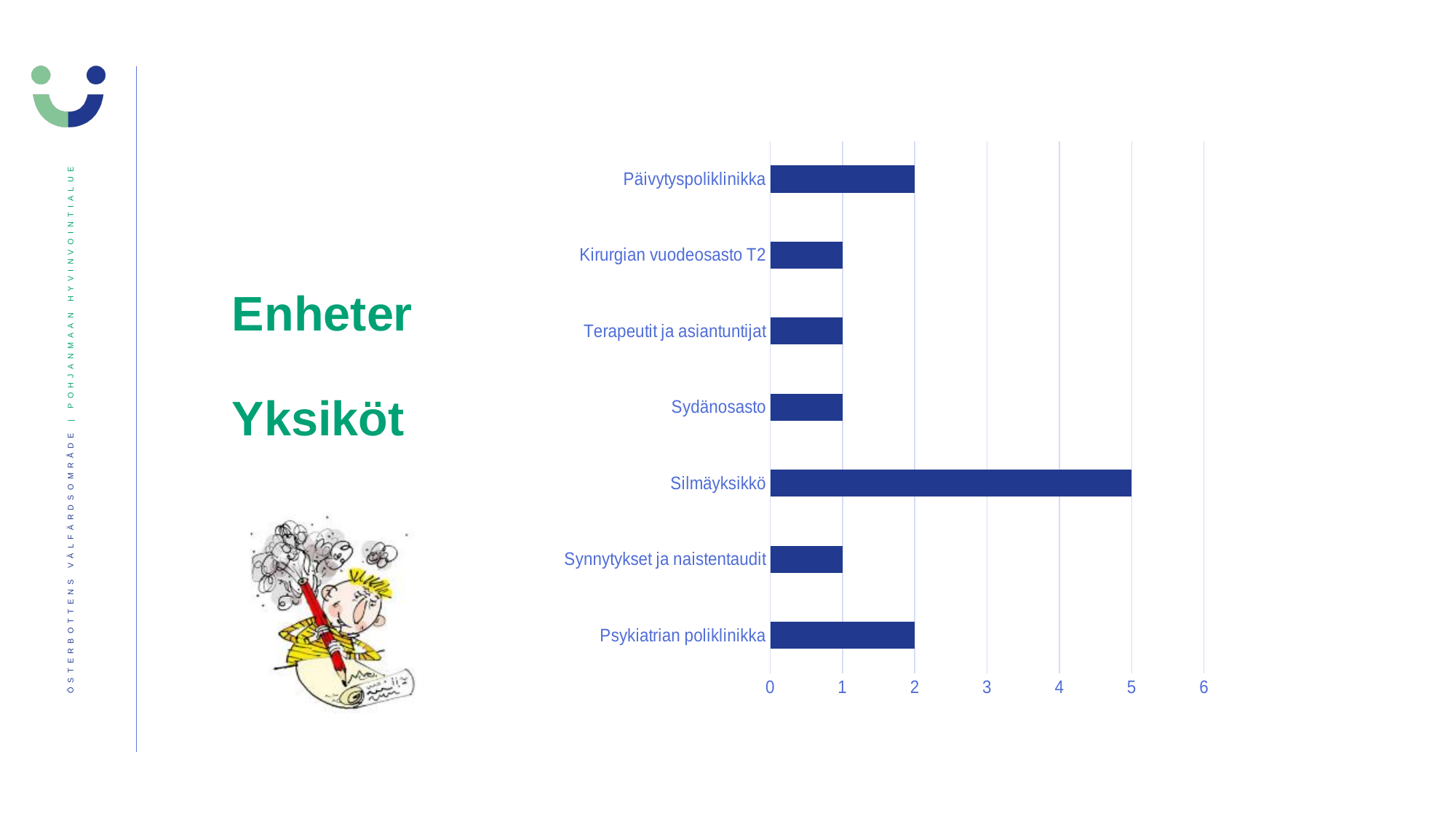
What is the value for Päivytyspoliklinikka? 2 What is the value for Psykiatrian poliklinikka? 2 What is the value for Sydänosasto? 1 How many categories are shown in the chart? 7 Is the value for Silmäyksikkö greater or less than 4? greater What is the value for Silmäyksikkö? 5 How many categories have a value of 1? 4 Which category has the highest value? Silmäyksikkö What kind of chart is shown on the slide? bar chart What is the highest value shown on the horizontal axis? 6 What is the difference between the values for Silmäyksikkö and Päivytyspoliklinikka? 3 Which is larger, the value for Psykiatrian poliklinikka or the value for Synnytykset ja naistentaudit? Psykiatrian poliklinikka